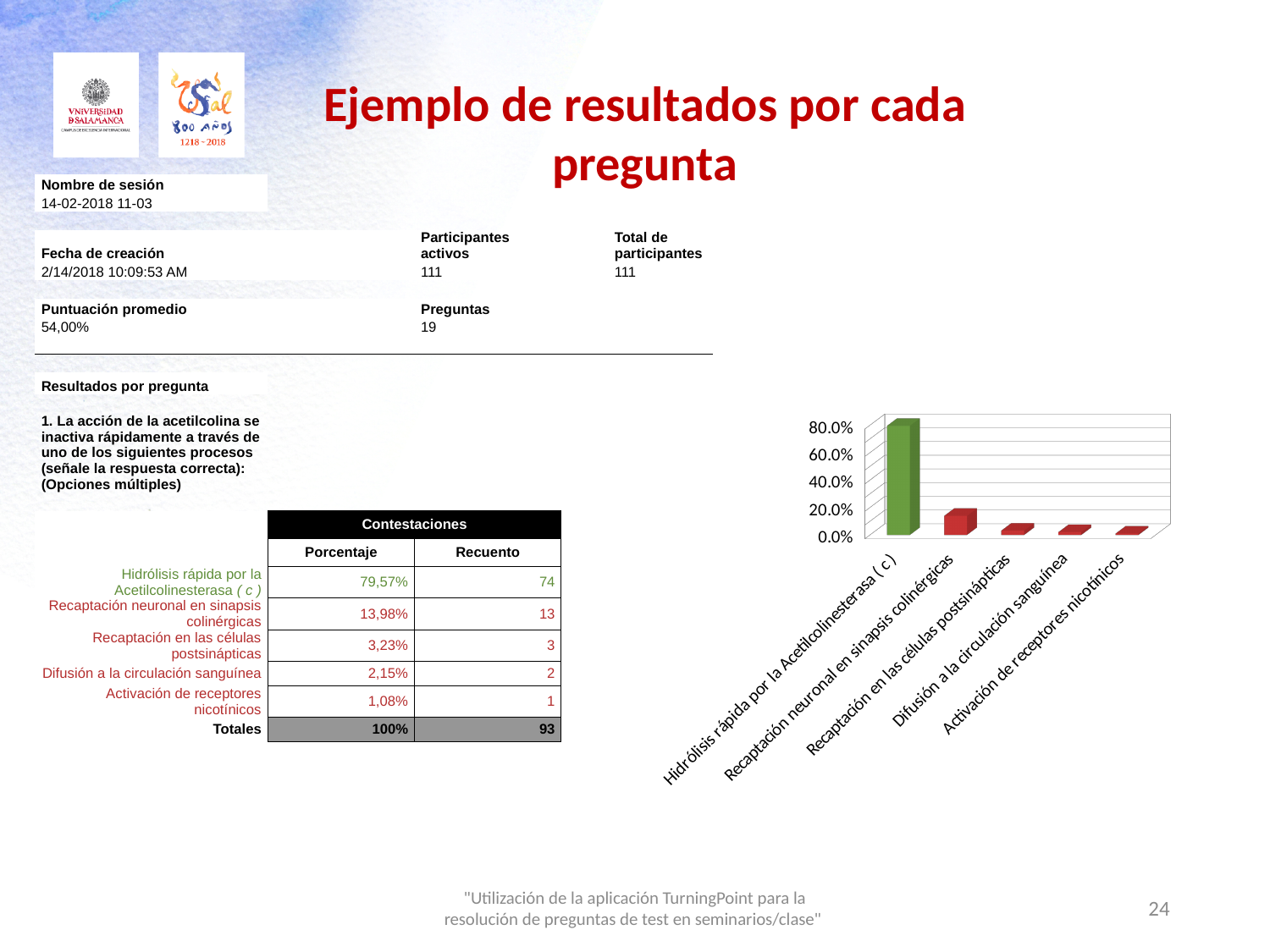
Which category has the highest bar in the chart? Hidrólisis rápida por la Acetilcolinesterasa ( c ) Which category has the lowest value in the chart? Activación de receptores nicotínicos Is the value for Difusión a la circulación sanguínea greater or less than 20.0%? less Is the value for Recaptación neuronal en sinapsis colinérgicas greater or less than 20.0%? less Which is larger: the value for Recaptación neuronal en sinapsis colinérgicas or for Recaptación en las células postsinápticas? Recaptación neuronal en sinapsis colinérgicas How many categories are plotted in the bar chart? 5 Is the value for Hidrólisis rápida por la Acetilcolinesterasa ( c ) greater or less than 60.0%? greater According to the slide, what percentage corresponds to Hidrólisis rápida por la Acetilcolinesterasa ( c )? 79,57% What kind of chart is shown on the slide? bar chart Do the bar values rise or fall from left to right along the x axis? fall According to the slide, what percentage corresponds to Recaptación en las células postsinápticas? 3,23% What colour is the tallest bar in the chart? green